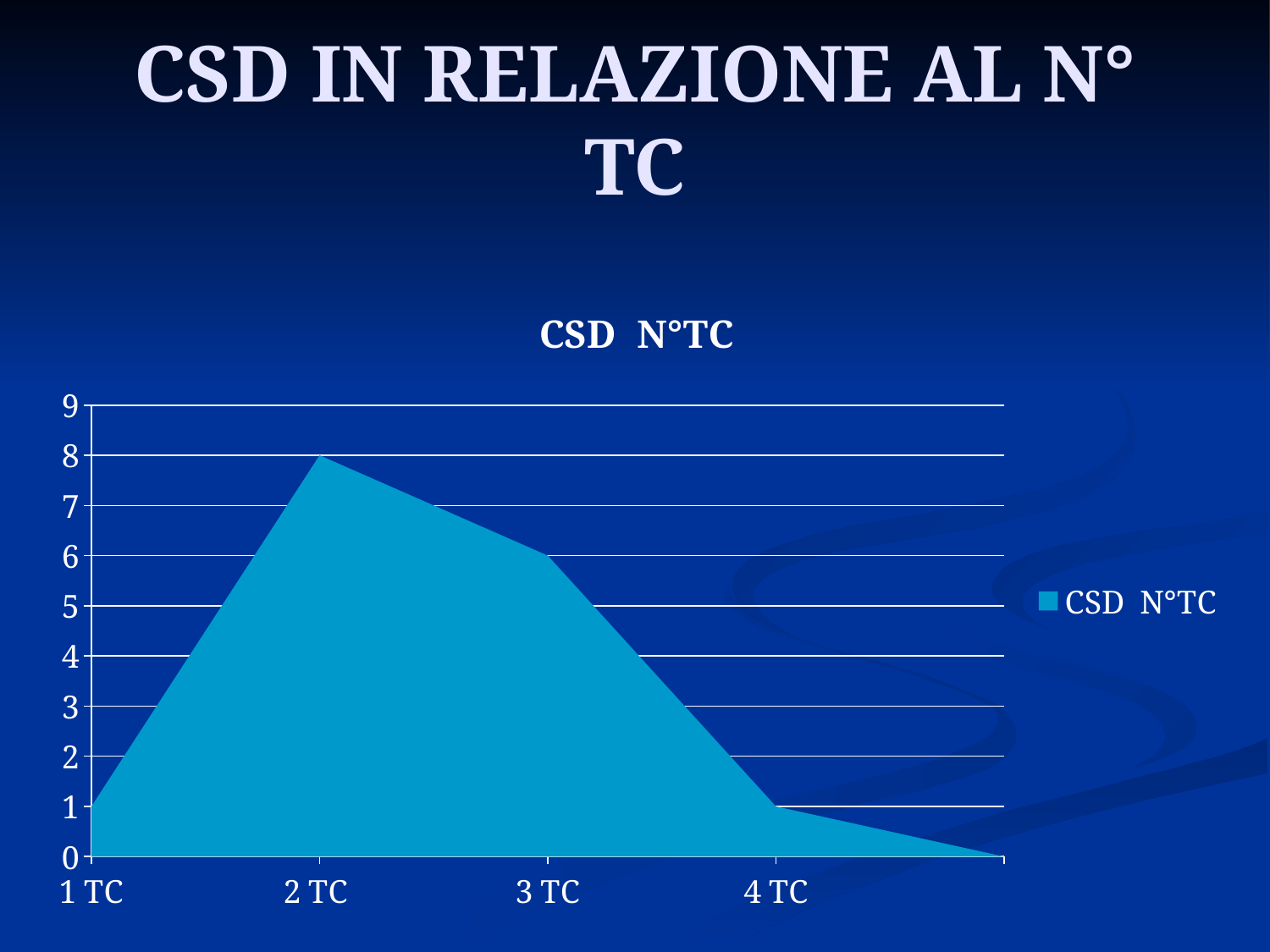
How many labeled categories are on the x axis? 4 What is the value for 3 TC? 6 What is the difference between the values for 2 TC and 3 TC? 2 What is the value for 4 TC? 1 How many series does the legend list? 1 What is the chart's title? CSD N°TC What kind of chart is shown on the slide? Area chart What is the value for 1 TC? 1 Is the value for 2 TC greater or less than 5? greater Which category has the highest value? 2 TC Which is larger, the value for 3 TC or the value for 4 TC? 3 TC What is the value for 2 TC? 8